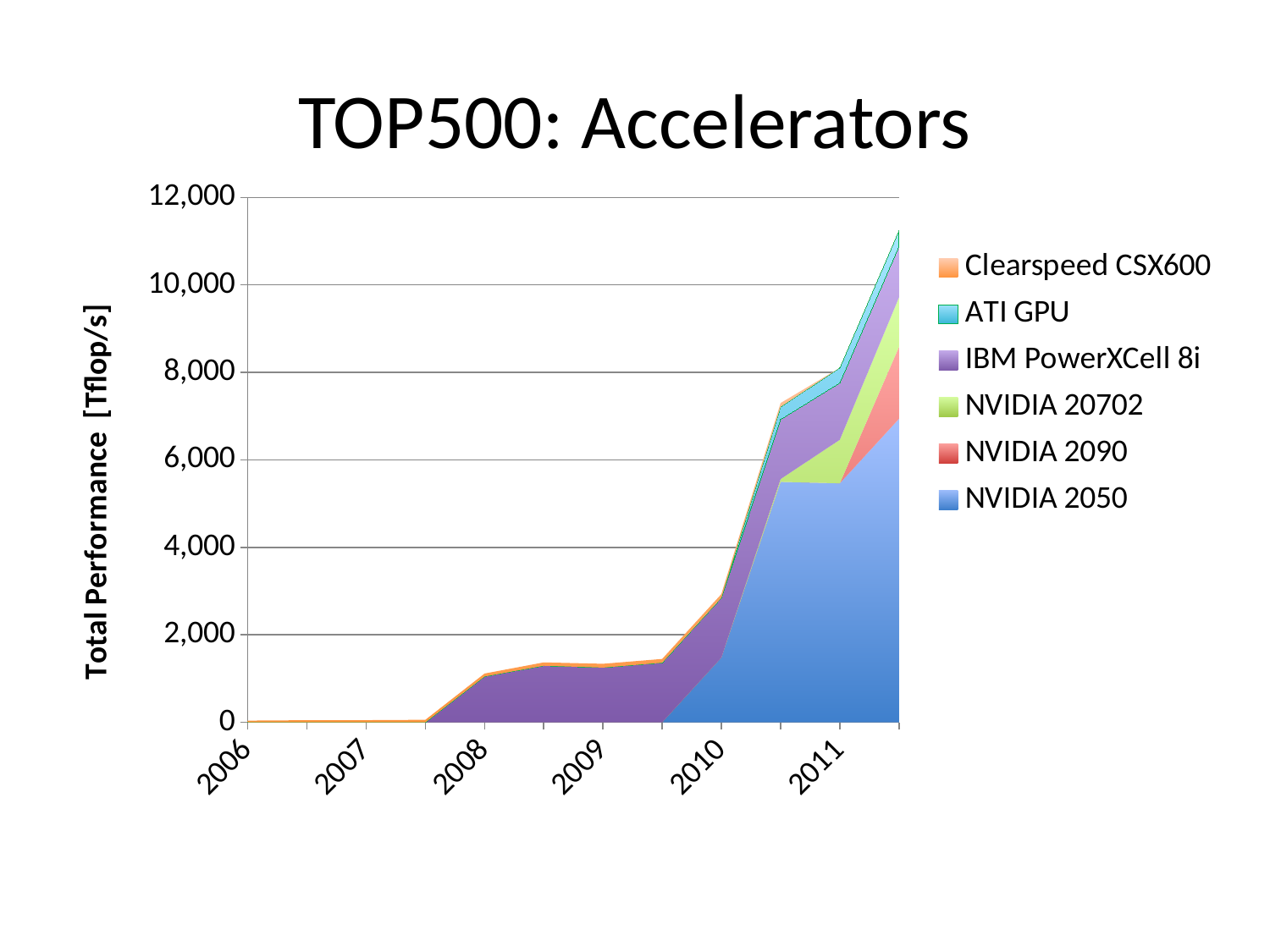
Which series contributes the largest share of total performance at the final point of the chart? NVIDIA 2050 What kind of chart is shown on the slide? Stacked area chart Does the total accelerator performance rise or fall from 2006 to the end of the chart? Rise What is the label on the vertical axis? Total Performance [Tflop/s] How many series does the legend list? 6 Is the total performance at 2010 greater or less than 4,000? less What is the title of the chart? TOP500: Accelerators How many year labels are shown on the x axis? 6 Which series is larger at the final point of the chart, NVIDIA 2050 or ATI GPU? NVIDIA 2050 Is the total performance at 2009 greater or less than 2,000? less Is the total performance at the final point of the chart greater or less than 10,000? greater